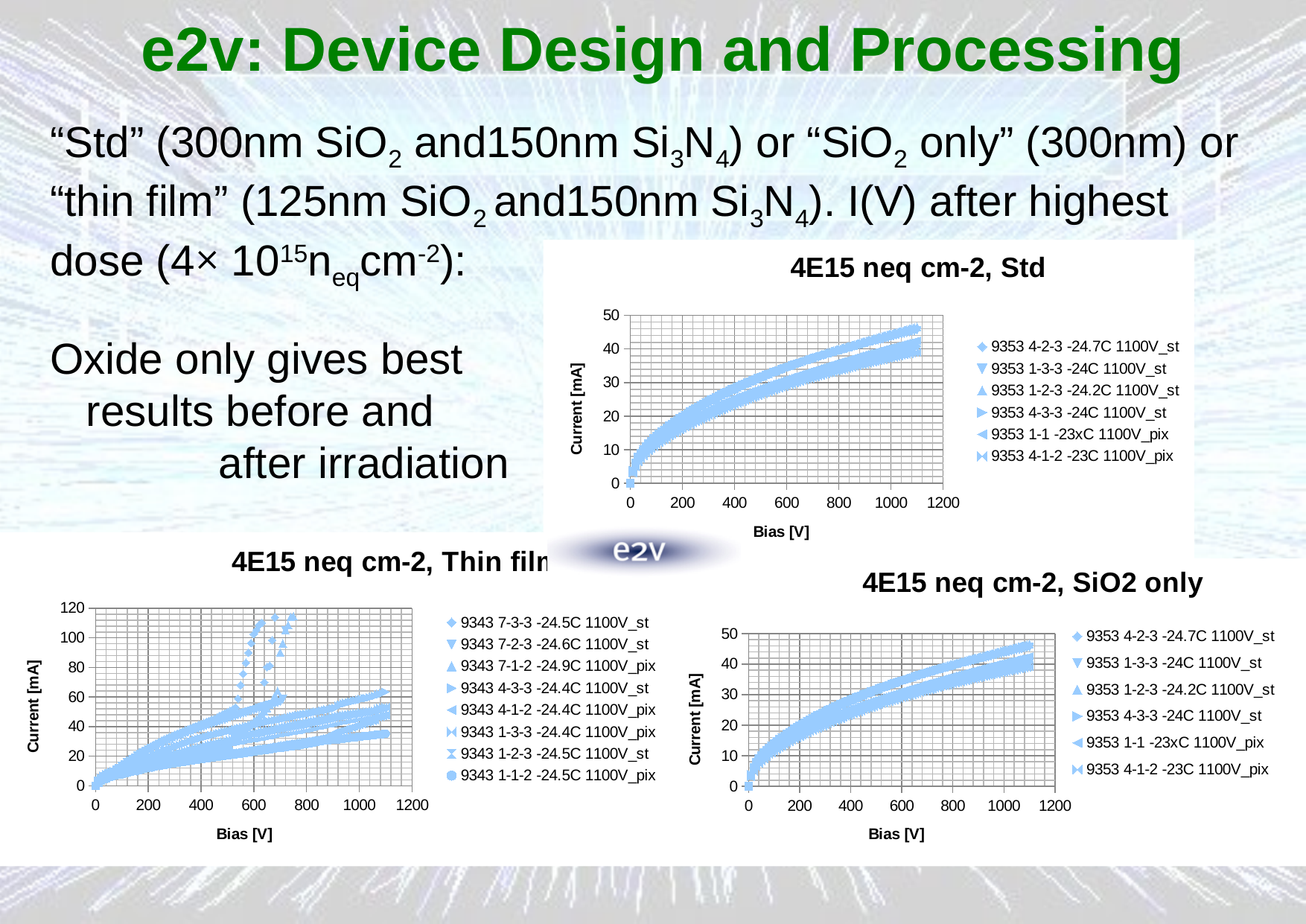
How many charts are shown on the slide? 3 How many series does the legend of the "4E15 neq cm-2, Thin film" chart list? 8 In the "4E15 neq cm-2, Thin film" chart, is the highest current value plotted greater or less than 100 mA? greater How many series does the legend of the "4E15 neq cm-2, SiO2 only" chart list? 6 How many series does the legend of the "4E15 neq cm-2, Std" chart list? 6 What is the label of the x axis on the "4E15 neq cm-2, SiO2 only" chart? Bias [V] What kind of chart is the "4E15 neq cm-2, Std" chart? scatter chart What is the label of the y axis on the "4E15 neq cm-2, Thin film" chart? Current [mA] In the "4E15 neq cm-2, Std" chart, does the current rise or fall as the bias increases? rise In the "4E15 neq cm-2, SiO2 only" chart, is the current at a bias of 200 V greater or less than 30 mA? less In the "4E15 neq cm-2, Std" chart, is the current at a bias of 1000 V greater or less than 30 mA? greater In the "4E15 neq cm-2, SiO2 only" chart, does the current rise or fall as the bias increases? rise